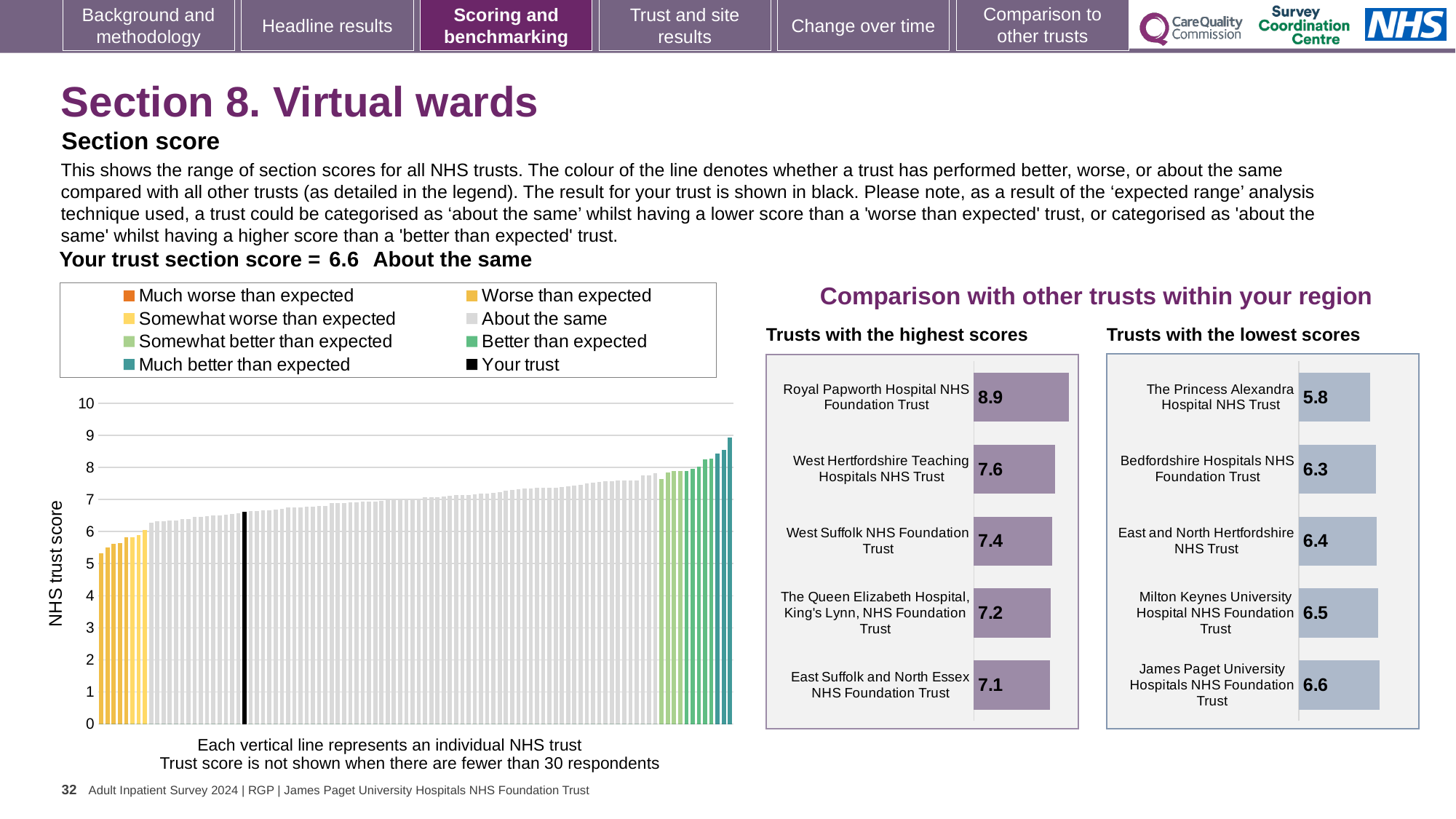
In the 'Trusts with the highest scores' chart, what is the difference between the scores of Royal Papworth Hospital NHS Foundation Trust and East Suffolk and North Essex NHS Foundation Trust? 1.8 In the large chart on the left showing NHS trust scores, is the value of the tallest bar greater or less than 8? greater In the 'Trusts with the lowest scores' chart, which has the larger score: Bedfordshire Hospitals NHS Foundation Trust or Milton Keynes University Hospital NHS Foundation Trust? Milton Keynes University Hospital NHS Foundation Trust In the 'Trusts with the highest scores' chart, what is the score for Royal Papworth Hospital NHS Foundation Trust? 8.9 How many entries does the legend of the large chart on the left list? 8 In the 'Trusts with the lowest scores' chart, what is the score for Bedfordshire Hospitals NHS Foundation Trust? 6.3 In the 'Trusts with the highest scores' chart, what is the score for West Suffolk NHS Foundation Trust? 7.4 How many trusts are shown in the 'Trusts with the highest scores' chart? 5 In the 'Trusts with the lowest scores' chart, what is the difference between the scores of James Paget University Hospitals NHS Foundation Trust and The Princess Alexandra Hospital NHS Trust? 0.8 In the 'Trusts with the lowest scores' chart, which trust has the lowest score? The Princess Alexandra Hospital NHS Trust What kind of chart is the large chart on the left showing NHS trust scores? Bar chart In the 'Trusts with the highest scores' chart, which trust has the highest score? Royal Papworth Hospital NHS Foundation Trust